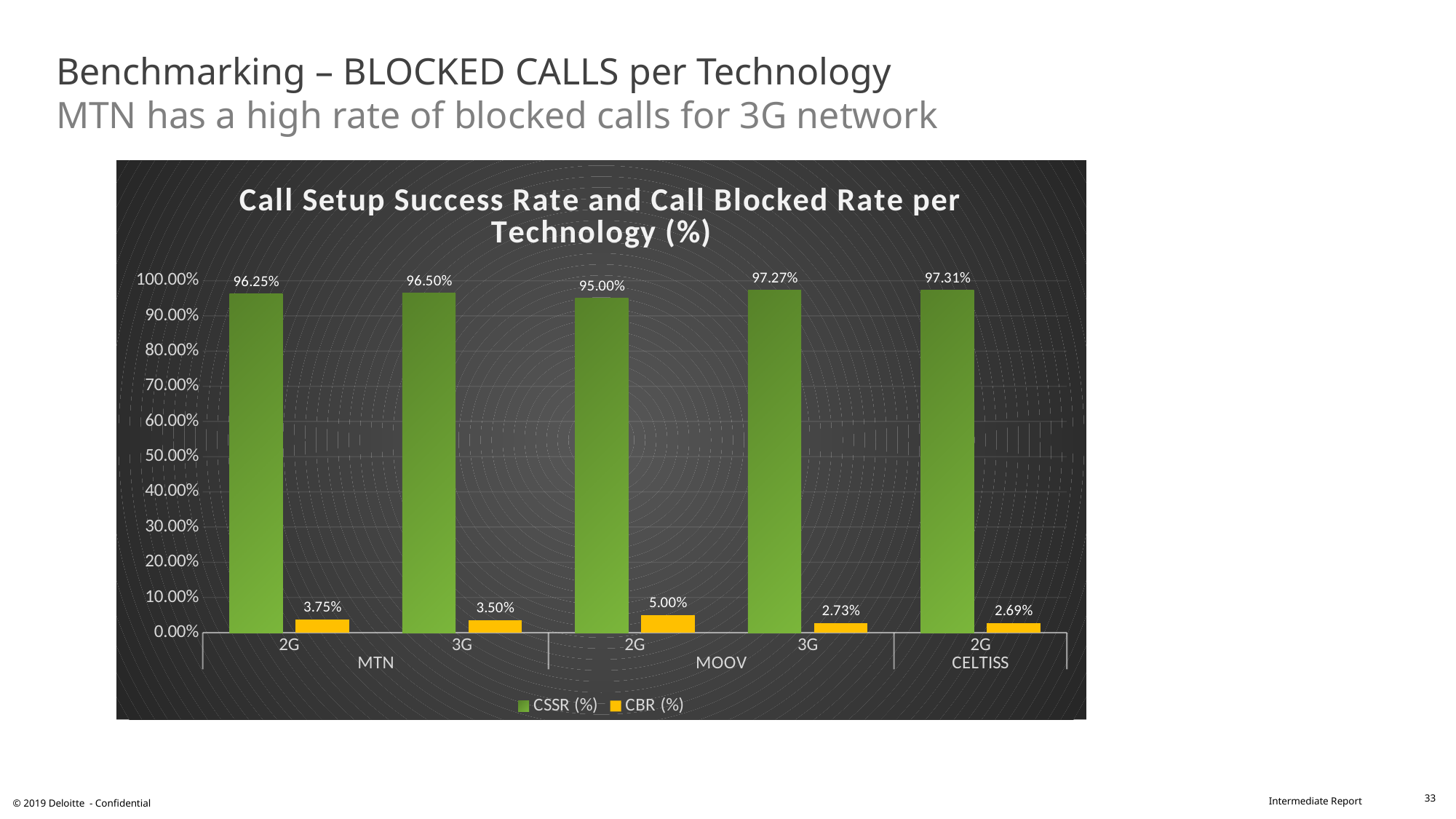
What is the CBR (%) value for MTN 3G? 3.50% How many technology categories are plotted on the x axis? 5 Which is larger, the CSSR (%) for MOOV 3G or for MTN 3G? MOOV 3G What is the CBR (%) value for MOOV 2G? 5.00% What is the difference between the CBR (%) for MTN 2G and MTN 3G? 0.25% Which category has the highest CBR (%)? MOOV 2G How many series does the legend list? 2 What is the CSSR (%) value for CELTISS 2G? 97.31% What kind of chart is shown on the slide? Bar chart What is the title of the chart? Call Setup Success Rate and Call Blocked Rate per Technology (%) What is the CSSR (%) value for MTN 2G? 96.25% Which category has the lowest CSSR (%)? MOOV 2G